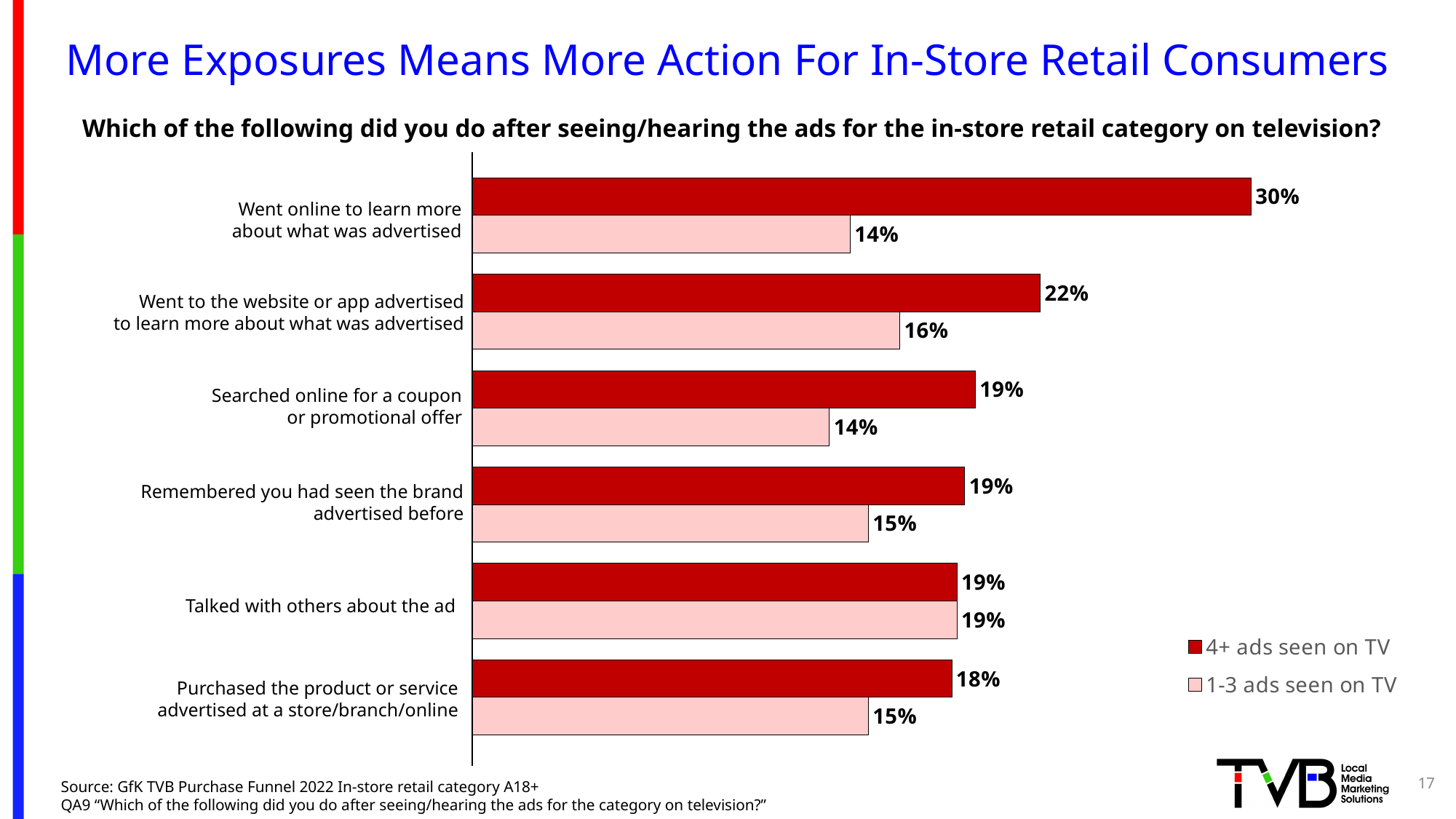
What type of chart is shown on the slide? Bar chart For 'Searched online for a coupon or promotional offer', which group has the larger value: 4+ ads seen on TV or 1-3 ads seen on TV? 4+ ads seen on TV How many actions (categories) are shown in the chart? 6 What is the difference between the 4+ ads and 1-3 ads values for 'Went online to learn more about what was advertised'? 16 percentage points What is the difference between the 4+ ads and 1-3 ads values for 'Went to the website or app advertised to learn more about what was advertised'? 6 percentage points For which action are the values for 4+ ads and 1-3 ads seen on TV equal? Talked with others about the ad What is the value for 'Purchased the product or service advertised at a store/branch/online' among those who saw 1-3 ads on TV? 15% Which action has the highest value for the 4+ ads seen on TV series? Went online to learn more about what was advertised What percentage of those who saw 4+ ads on TV went online to learn more about what was advertised? 30% How many series does the legend list? 2 What percentage of those who saw 1-3 ads on TV went to the website or app advertised to learn more about what was advertised? 16% Which action has the lowest value for the 4+ ads seen on TV series? Purchased the product or service advertised at a store/branch/online